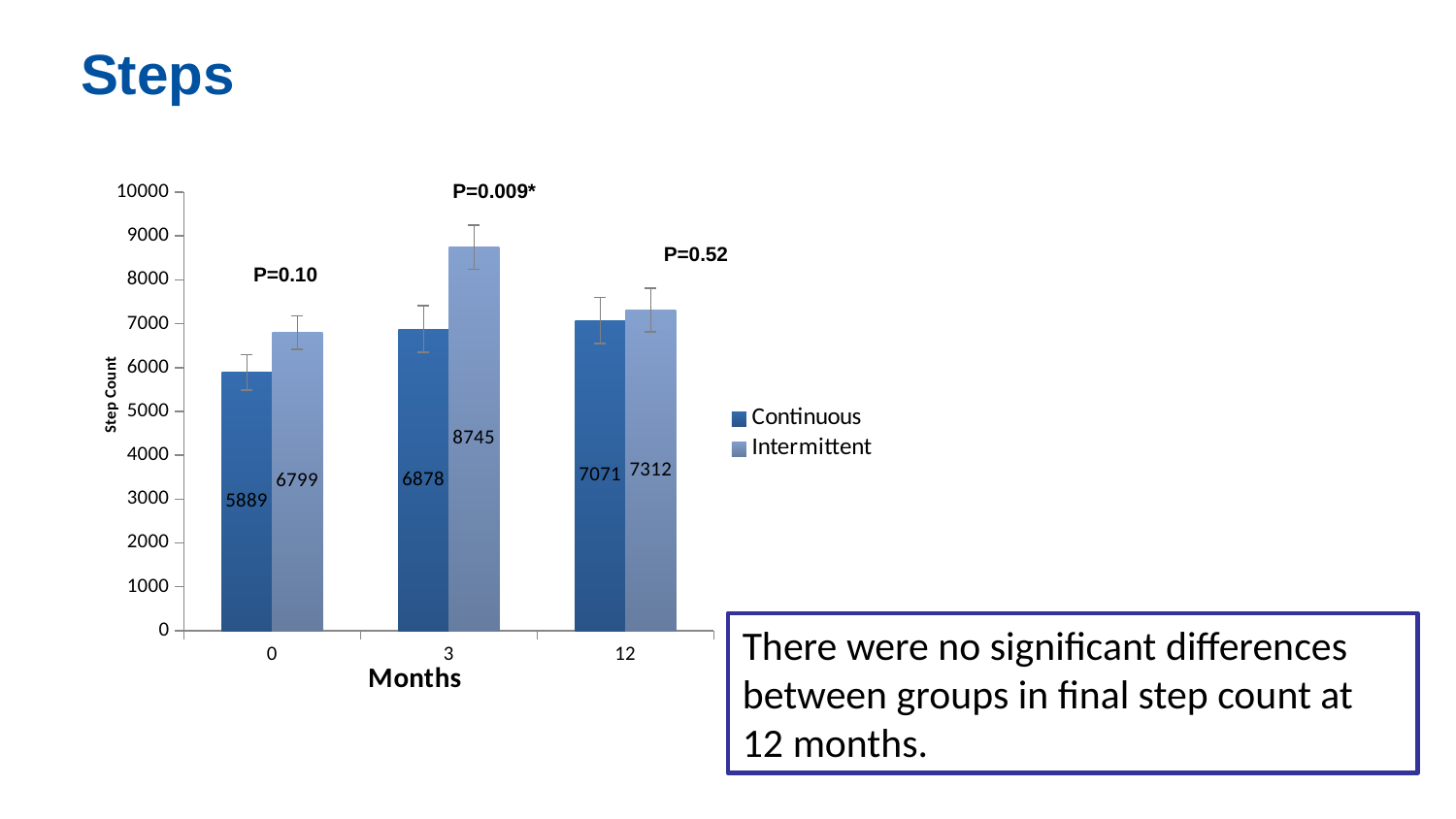
Which month has the lowest step count for the Continuous group? 0 What kind of chart is shown on the slide? Bar chart What is the difference between the Intermittent and Continuous step counts at 3 months? 1867 Which group has the larger step count at 0 months, Continuous or Intermittent? Intermittent What is the step count for the Intermittent group at 0 months? 6799 Which month has the highest step count for the Intermittent group? 3 What is the step count for the Continuous group at 12 months? 7071 How many month categories are shown on the x axis? 3 What is the step count for the Intermittent group at 3 months? 8745 Does the step count for the Continuous group rise or fall from 0 to 12 months? Rise How many series does the legend list? 2 What is the step count for the Continuous group at 0 months? 5889